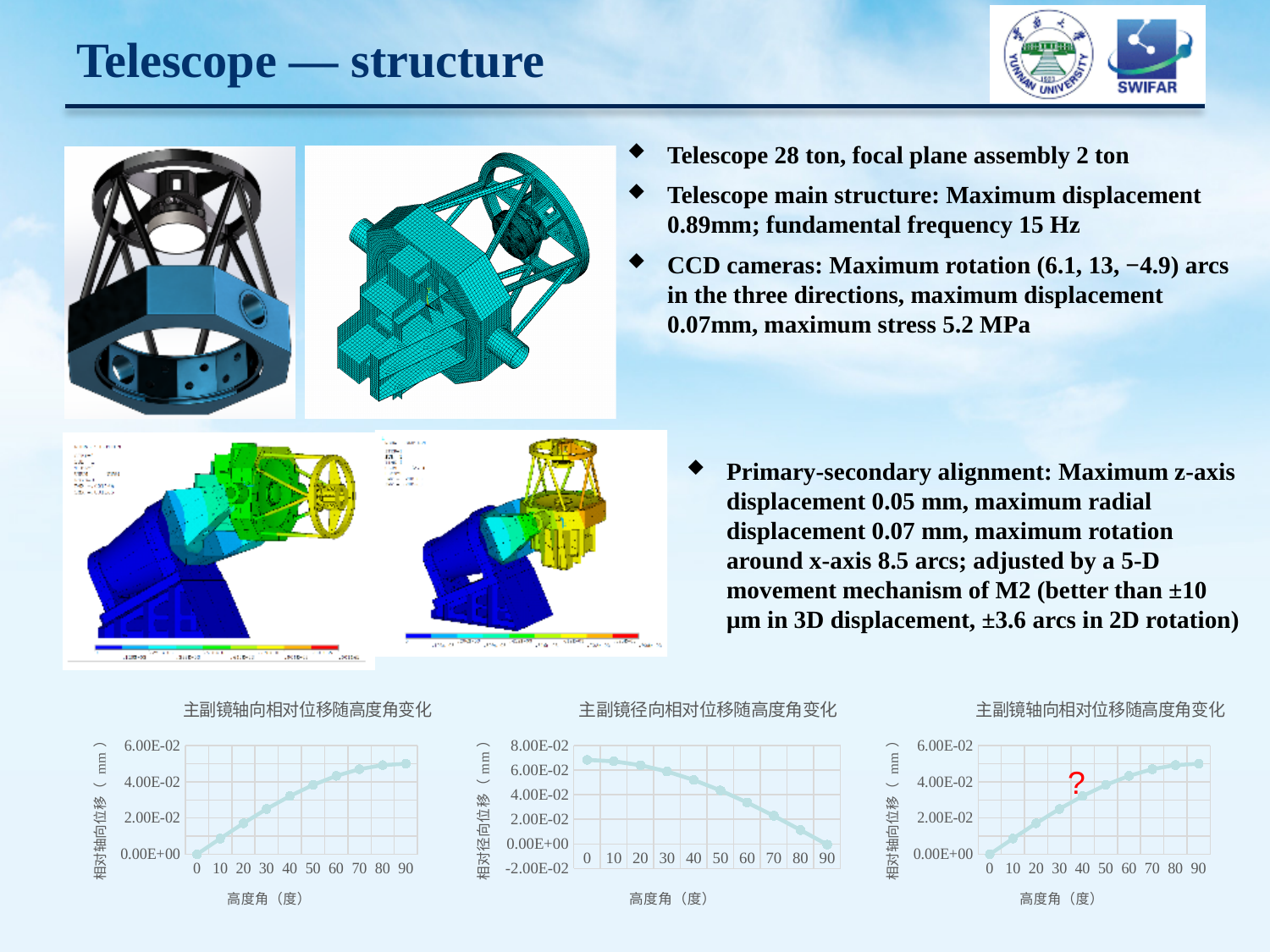
In the bottom-right chart, do the values rise or fall along the x axis? rise In the bottom-middle chart (主副镜径向相对位移随高度角变化), do the values rise or fall as the elevation angle increases from 0 to 90? fall In the bottom-right chart, which is larger: the value at elevation angle 30 or the value at elevation angle 80? 80 What type of chart is the bottom-left chart on the slide? line chart In the bottom-middle chart (主副镜径向相对位移随高度角变化), at which elevation angle is the value highest? 0 In the bottom-middle chart (主副镜径向相对位移随高度角变化), is the value at elevation angle 90 greater or less than 2.00E-02? less In the bottom-left chart, is the value at elevation angle 90 greater or less than 4.00E-02? greater In the bottom-right chart, at which elevation angle is the value lowest? 0 In the bottom-left chart, is the value at elevation angle 10 greater or less than 2.00E-02? less How many data points are plotted in the bottom-middle chart (主副镜径向相对位移随高度角变化)? 10 In the bottom-left chart, do the values rise or fall as the elevation angle (高度角) increases from 0 to 90? rise